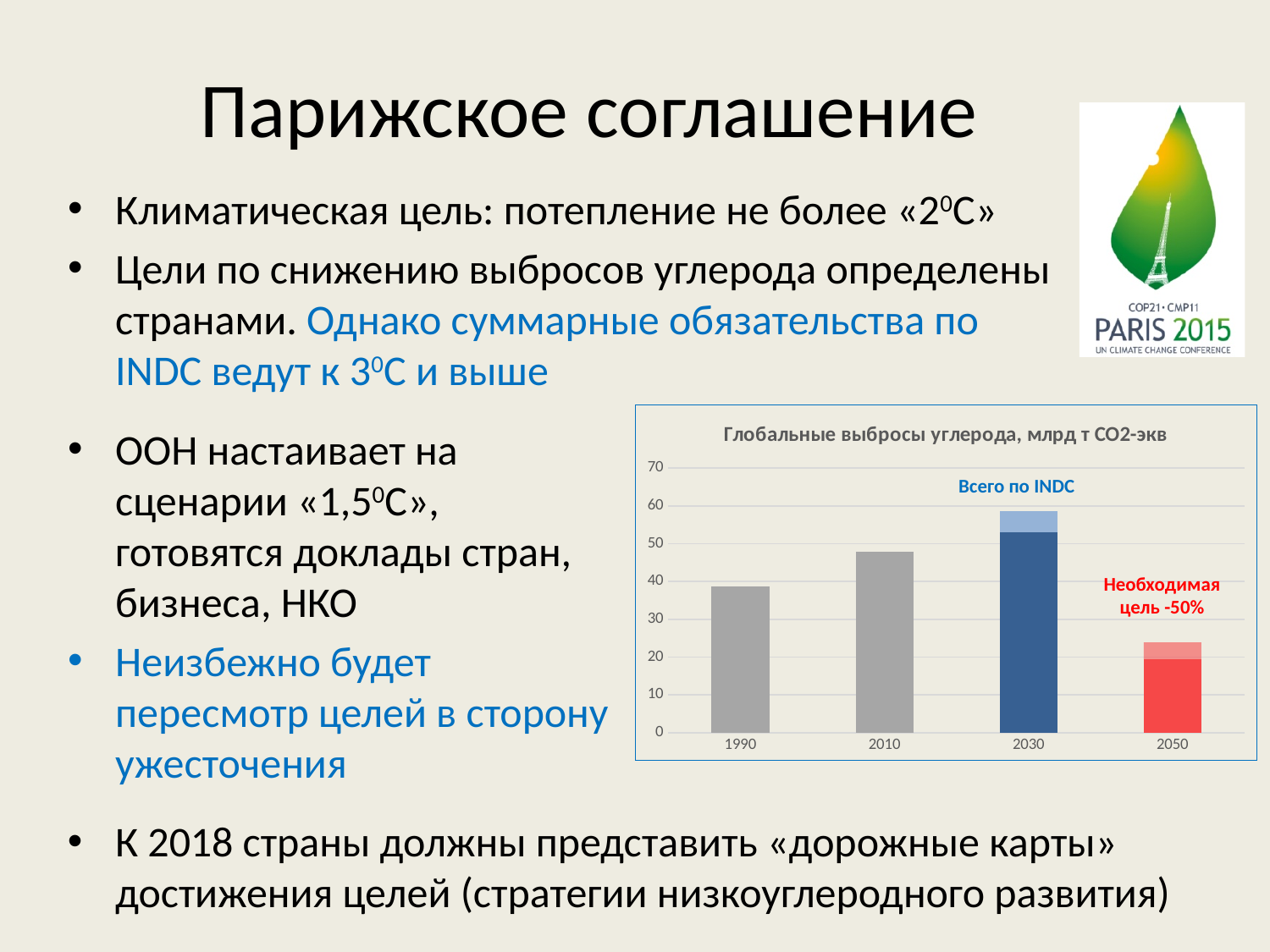
Is the value for 2030 greater or less than 50? greater How many years (categories) are shown on the x axis of the chart? 4 What label is written above the 2030 bar in the chart? Всего по INDC What kind of chart is shown on the slide? bar chart What is the title of the chart? Глобальные выбросы углерода, млрд т CO2-экв Which bar is taller, 1990 or 2010? 2010 Do the values rise or fall from 1990 to 2030? rise Is the value for 1990 greater or less than 40? less Is the value for 2050 greater or less than 30? less Which year has the lowest bar in the chart? 2050 Which year has the highest bar in the chart? 2030 Which bar is taller, 2030 or 2050? 2030